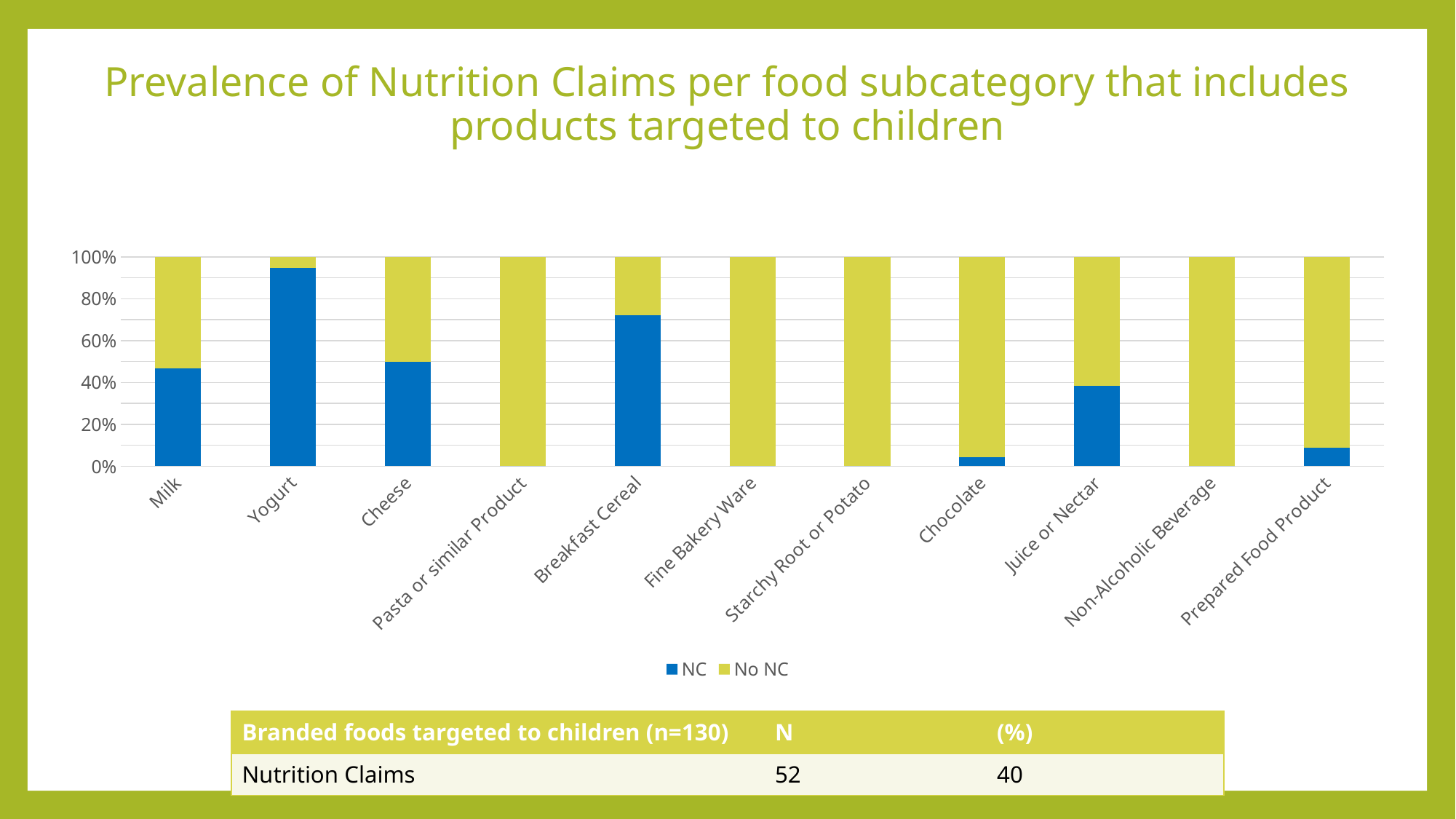
Which has a larger NC share, Breakfast Cereal or Cheese? Breakfast Cereal Is the NC value for Chocolate greater or less than 20%? less How many series does the chart legend list? 2 Is the NC value for Yogurt greater or less than 80%? greater Is the NC value for Breakfast Cereal greater or less than 60%? greater How many food subcategories are shown on the x axis of the chart? 11 What kind of chart is shown on the slide? bar chart Which food subcategory has the highest NC share in the chart? Yogurt What is the total of the stacked bar for Milk? 100% Which colour represents the NC series in the chart legend? blue